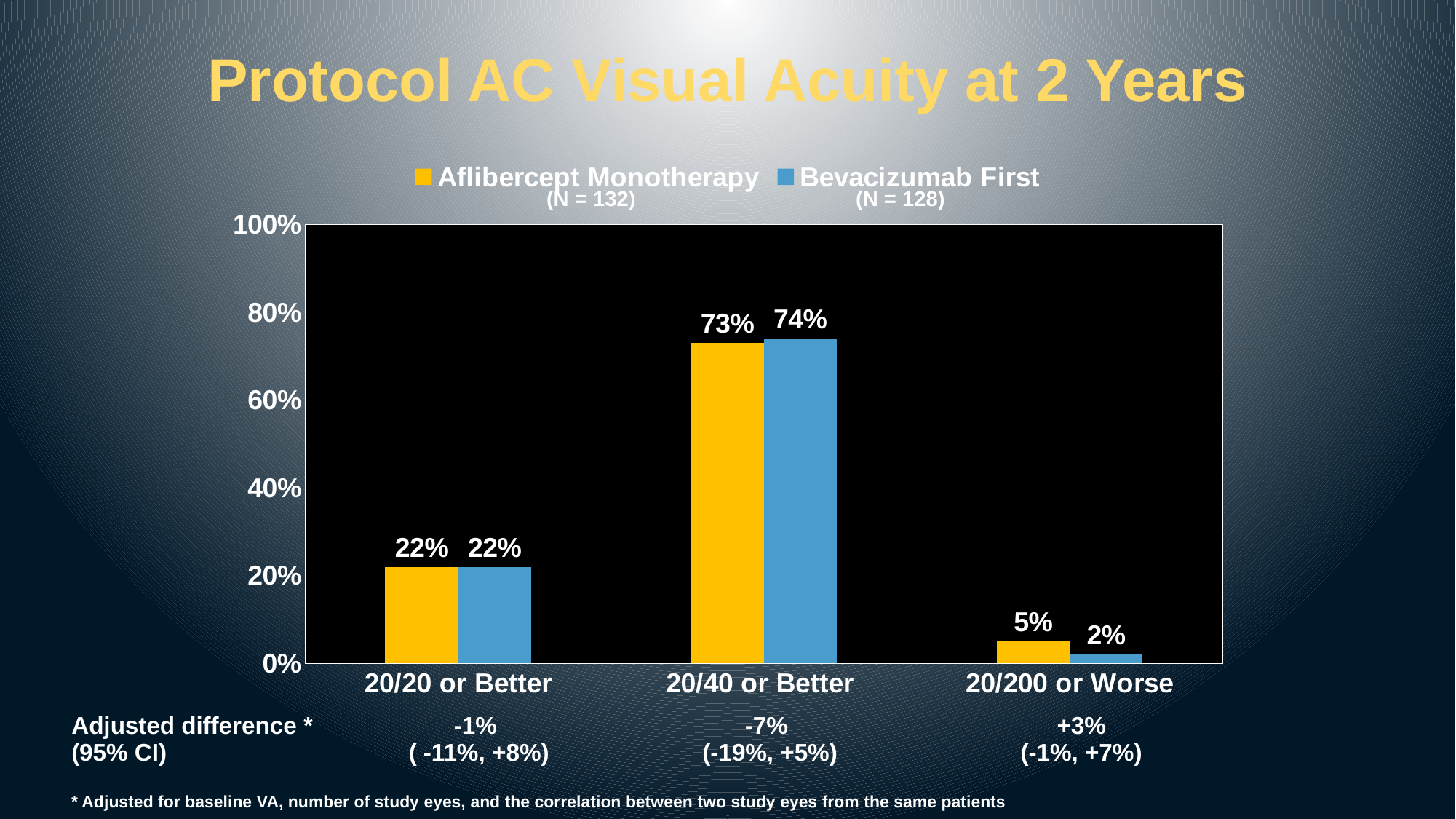
Which category has the highest value for Bevacizumab First? 20/40 or Better In the 20/200 or Worse category, which series has the larger value, Aflibercept Monotherapy or Bevacizumab First? Aflibercept Monotherapy What is the difference between the Aflibercept Monotherapy and Bevacizumab First values in the 20/200 or Worse category? 3% What is the value for Aflibercept Monotherapy in the 20/40 or Better category? 73% What is the value for Bevacizumab First in the 20/200 or Worse category? 2% Is the value for Bevacizumab First in the 20/40 or Better category greater or less than 60%? greater How many categories are shown on the x axis? 3 What kind of chart is shown on the slide? bar chart What is the sample size (N) for the Bevacizumab First group shown in the legend? N = 128 Which category has the lowest value for Aflibercept Monotherapy? 20/200 or Worse What is the value for Bevacizumab First in the 20/20 or Better category? 22% How many series does the legend list? 2